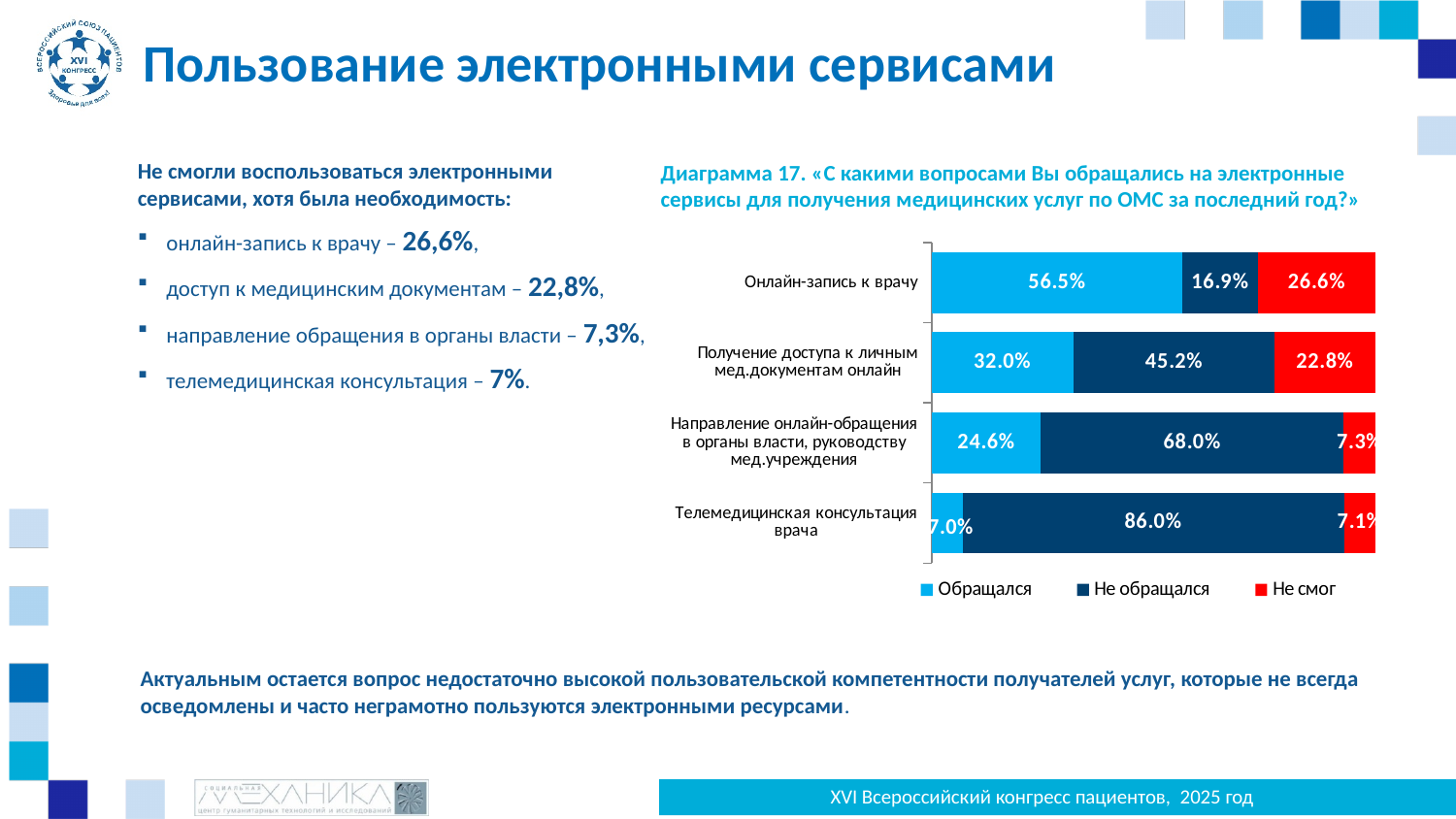
What is the value of «Обращался» for «Онлайн-запись к врачу»? 56.5% Which is larger: the «Не смог» value for «Онлайн-запись к врачу» or for «Получение доступа к личным мед.документам онлайн»? Онлайн-запись к врачу Which series is shown in red in the chart legend? Не смог What type of chart is shown on the slide? Stacked bar chart What is the value of «Не обращался» for «Телемедицинская консультация врача»? 86.0% What is the value of «Не смог» for «Получение доступа к личным мед.документам онлайн»? 22.8% What is the total of the stacked bar for «Получение доступа к личным мед.документам онлайн»? 100.0% How many categories are shown in the chart? 4 How many series does the chart legend list? 3 Which category has the lowest value for «Не обращался»? Онлайн-запись к врачу Which category has the highest value for «Обращался»? Онлайн-запись к врачу What is the difference between the «Не обращался» values for «Телемедицинская консультация врача» and «Направление онлайн-обращения в органы власти, руководству мед.учреждения»? 18.0%